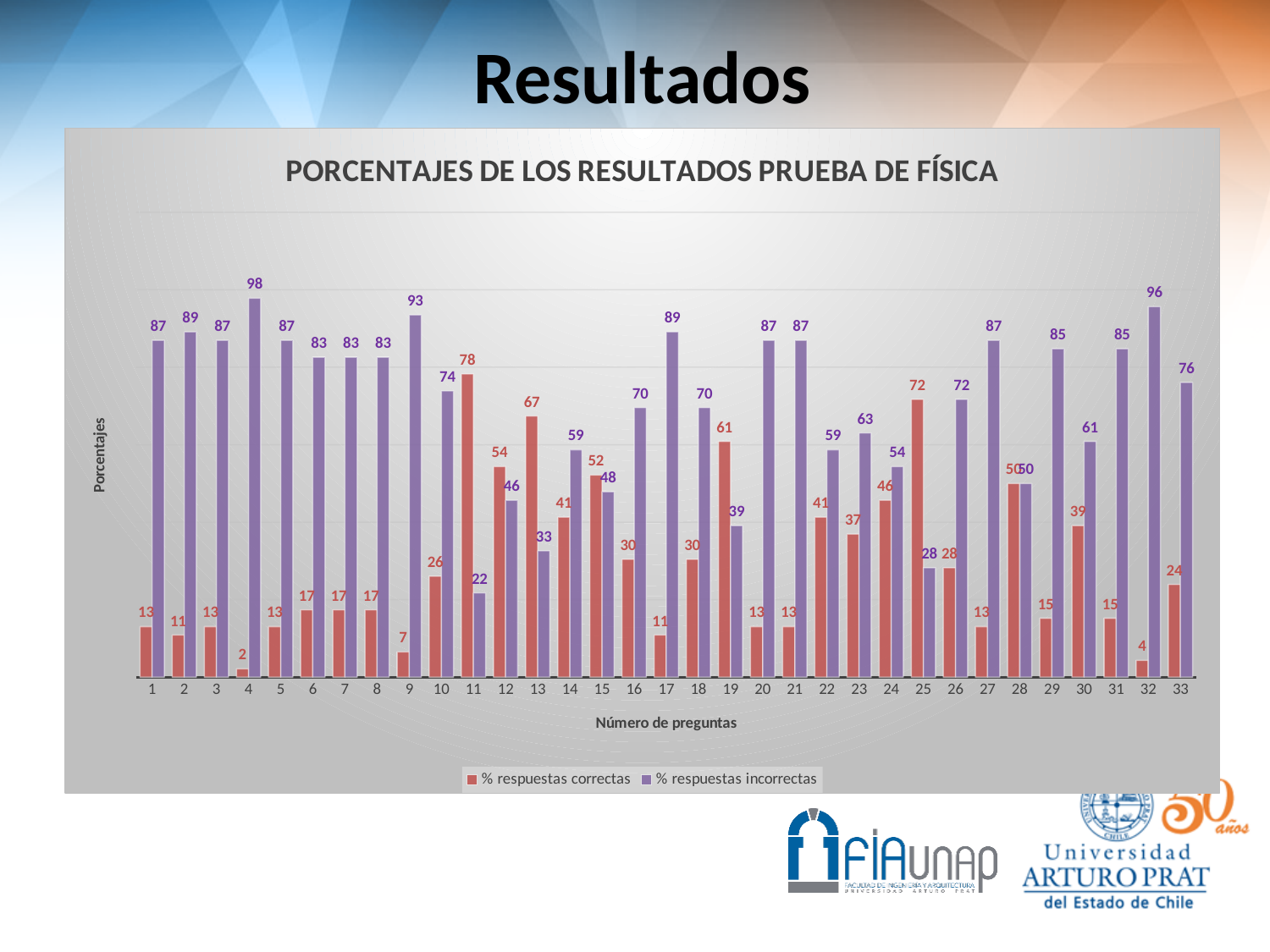
What is the value of % respuestas incorrectas for question 4? 98 What type of chart is shown on the slide? bar chart How many questions (categories) are shown on the x axis? 33 Which question has the lowest % respuestas correctas? 4 What is the value of % respuestas correctas for question 11? 78 Which question has the lowest % respuestas incorrectas? 11 What is the value of % respuestas correctas for question 28? 50 How many series does the legend list? 2 What is the difference between % respuestas incorrectas and % respuestas correctas for question 13? 34 Which question has the highest % respuestas correctas? 11 For question 25, which is larger: % respuestas correctas or % respuestas incorrectas? % respuestas correctas What is the title of the chart? PORCENTAJES DE LOS RESULTADOS PRUEBA DE FÍSICA